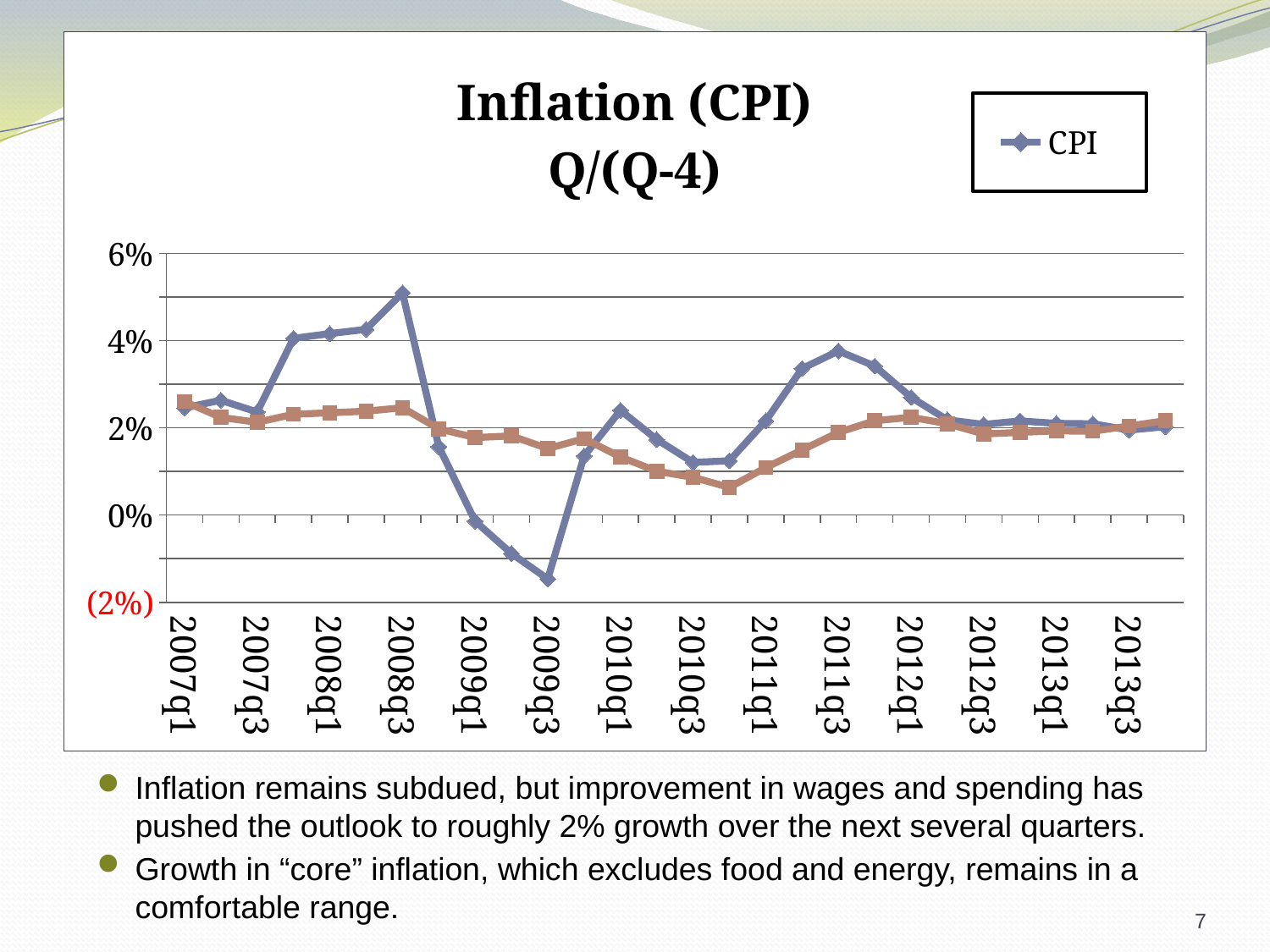
Which is higher, the CPI value at 2008q3 or at 2011q3? 2008q3 Is the CPI value for 2008q3 greater or less than 4%? greater Is the CPI value for 2010q3 greater or less than 2%? less What kind of chart is shown on the slide? line chart Is the CPI value for 2011q3 greater or less than 2%? greater How many quarter labels are shown on the x axis? 14 Does the CPI line rise or fall between 2008q3 and 2009q3? fall What is the title of the chart? Inflation (CPI) Q/(Q-4) How many series does the legend list? 1 At which quarter does the CPI line reach its highest value? 2008q3 At which quarter does the CPI line reach its lowest value? 2009q3